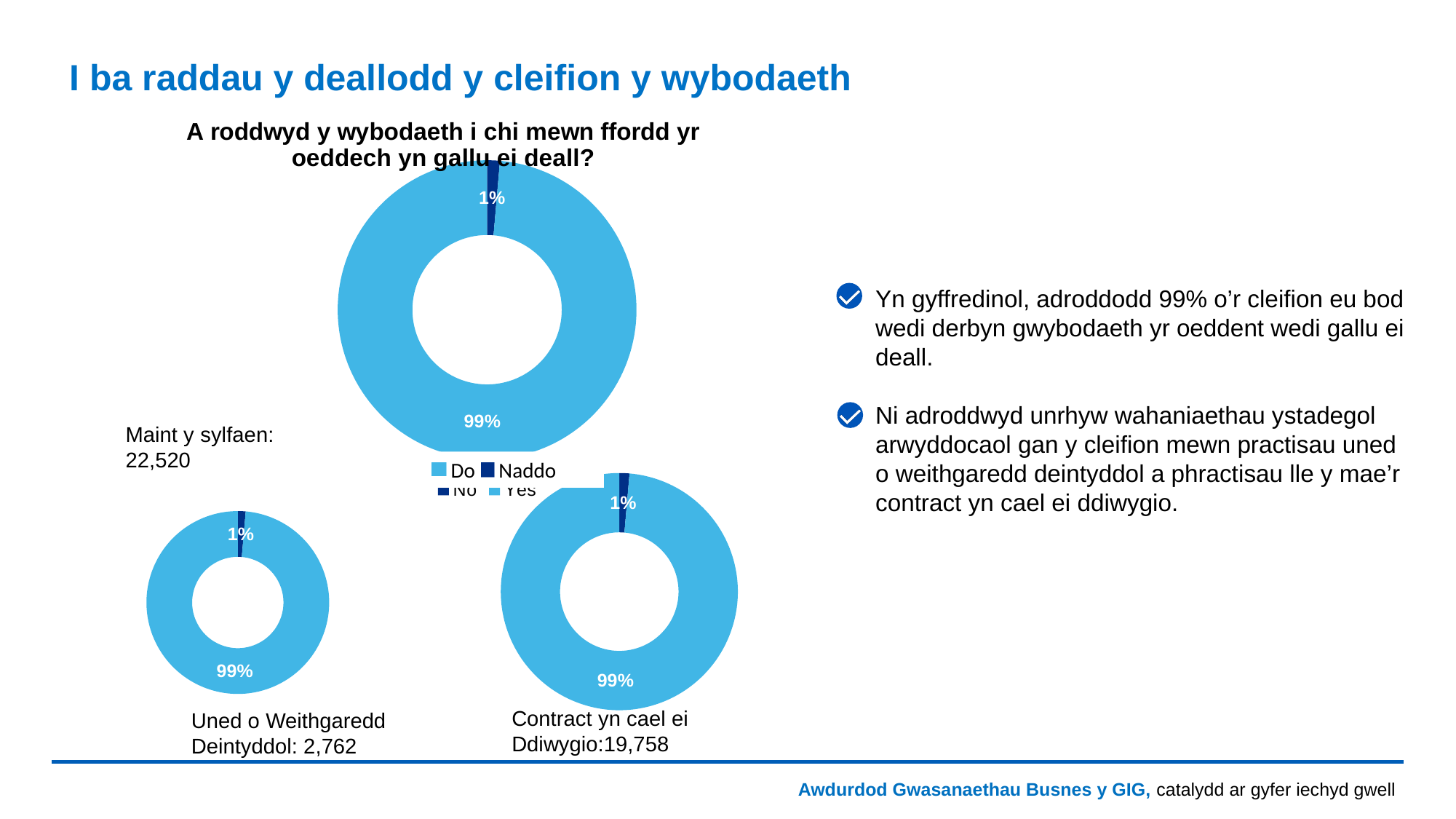
In the large chart at the top, is the 'Do' slice larger or smaller than the 'Naddo' slice? Larger In the large chart at the top, which category has the smallest slice? Naddo In the large chart titled 'A roddwyd y wybodaeth i chi mewn ffordd yr oeddech yn gallu ei deall?', what share is labelled for 'Do'? 99% In the large chart at the top, what is the difference between the 'Do' and 'Naddo' percentages? 98% In the small chart at the bottom left labelled 'Uned o Weithgaredd Deintyddol: 2,762', what is the larger percentage shown? 99% In the large chart titled 'A roddwyd y wybodaeth i chi mewn ffordd yr oeddech yn gallu ei deall?', what share is labelled for 'Naddo'? 1% How many doughnut charts are shown on the slide? 3 In the small chart at the bottom right labelled 'Contract yn cael ei Ddiwygio:19,758', what is the smaller percentage shown? 1% How many categories does the legend of the large chart list? 2 In the large chart at the top, which category has the largest slice? Do What base size ('Maint y sylfaen') is stated next to the large chart? 22,520 What kind of chart is the large chart at the top of the slide? Doughnut (pie) chart